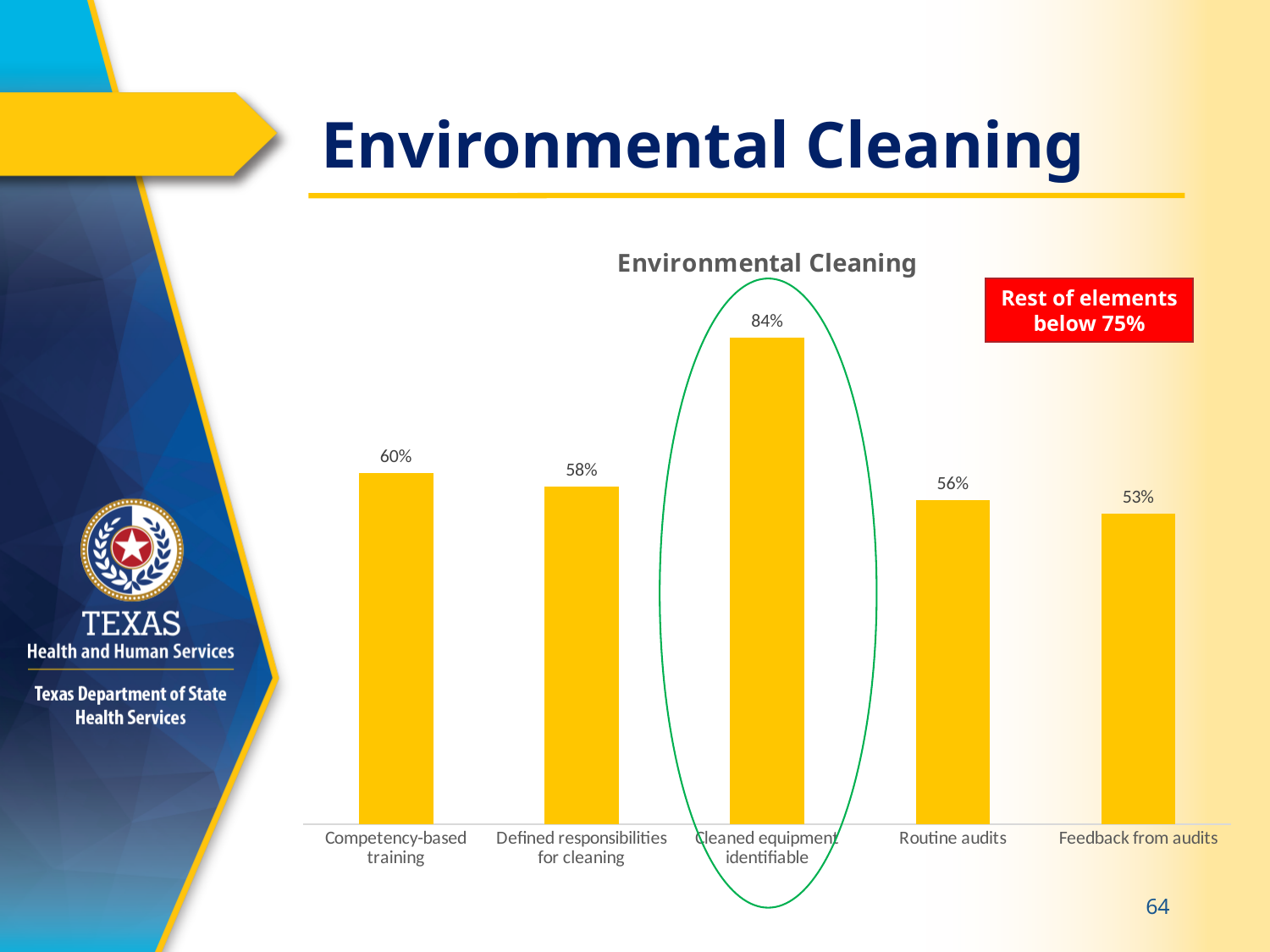
Which is larger, the value for Defined responsibilities for cleaning or the value for Routine audits? Defined responsibilities for cleaning How many categories are shown in the chart? 5 What is the difference between the values for Cleaned equipment identifiable and Feedback from audits? 31% Which category has the highest value? Cleaned equipment identifiable What is the value for Cleaned equipment identifiable? 84% What is the title of the chart? Environmental Cleaning What is the value for Routine audits? 56% What is the difference between the values for Competency-based training and Defined responsibilities for cleaning? 2% Which category has the lowest value? Feedback from audits What is the value for Feedback from audits? 53% What is the value for Competency-based training? 60% What kind of chart is shown on the slide? Bar chart